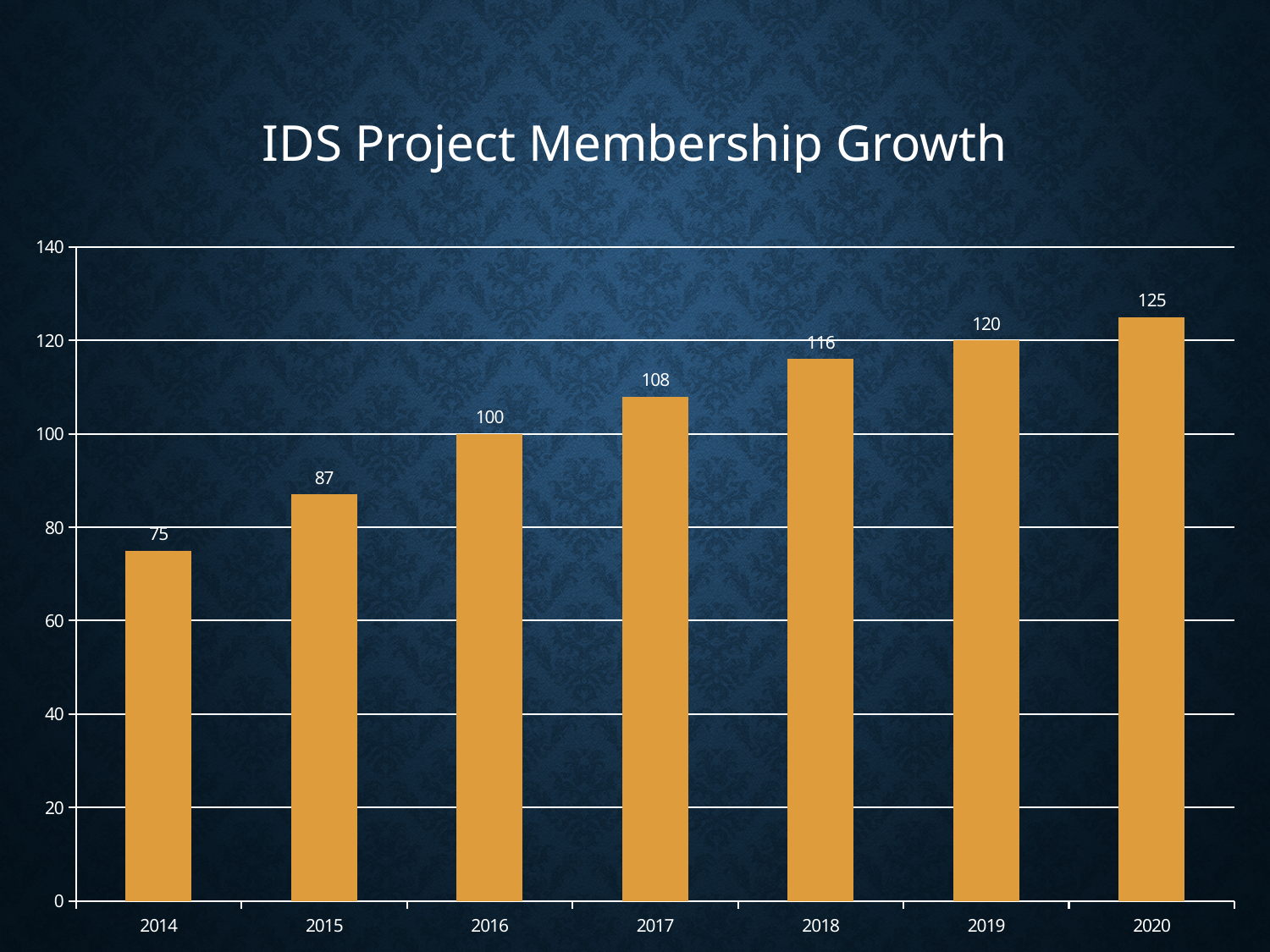
Which year has the lowest value? 2014 What is the difference between the values for 2017 and 2015? 21 What is the value for 2016? 100 What is the title of the chart? IDS Project Membership Growth Which year has the highest value? 2020 What is the value for 2019? 120 Do the values rise or fall from 2014 to 2020? rise Which is larger, the value for 2018 or the value for 2016? 2018 What kind of chart is shown on the slide? bar chart Is the value for 2015 greater or less than 80? greater What is the difference between the values for 2020 and 2014? 50 How many years are shown on the x axis? 7